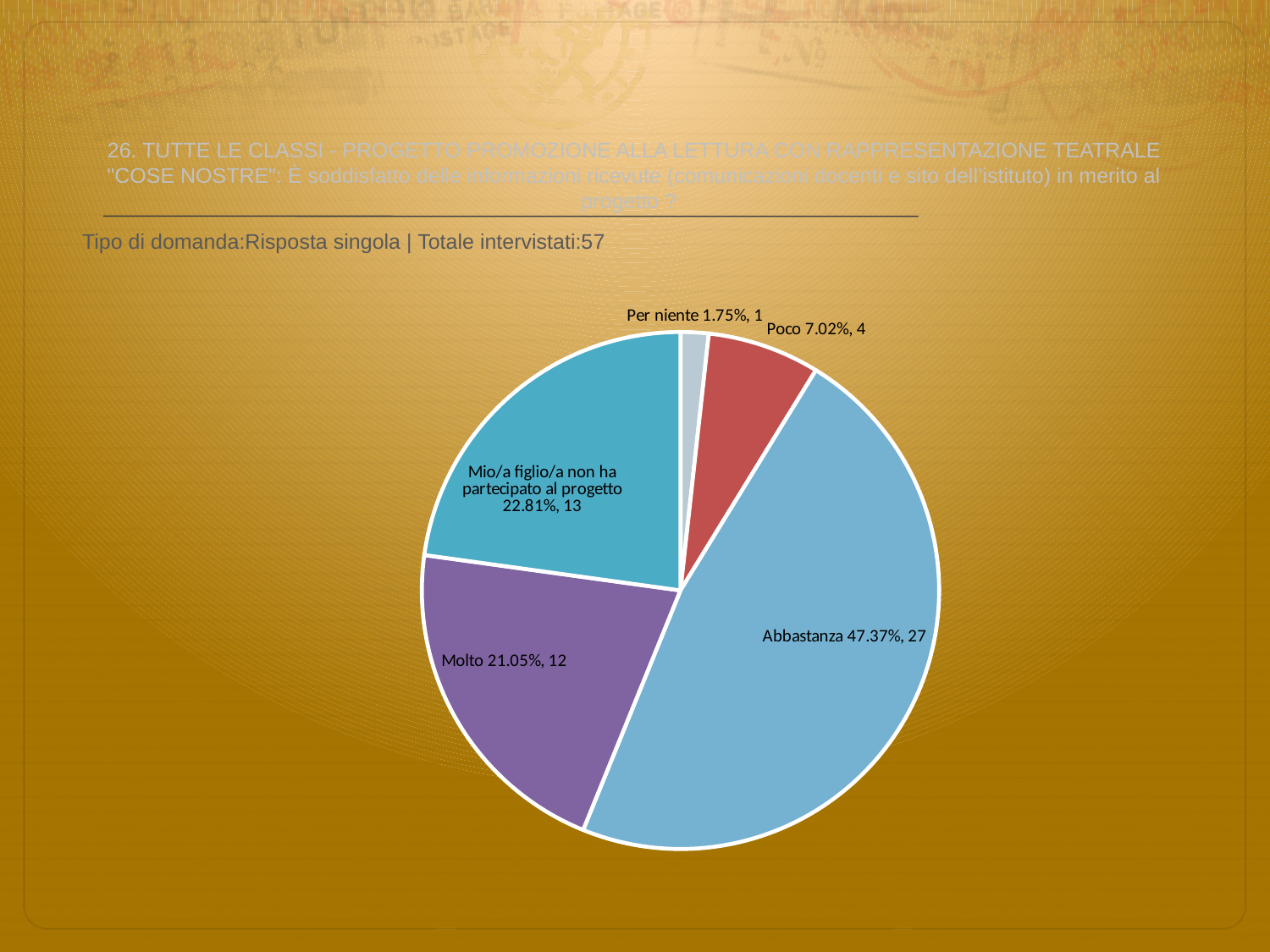
What percentage share does the 'Poco' slice have? 7.02% How many slices does the pie chart have? 5 What is the difference in respondent count between 'Abbastanza' and 'Molto'? 15 What percentage share does the 'Per niente' slice have? 1.75% Which category has the largest slice of the pie? Abbastanza Which category has the smallest slice of the pie? Per niente How many respondents answered 'Mio/a figlio/a non ha partecipato al progetto'? 13 What kind of chart is shown on the slide? pie chart How many respondents answered 'Molto'? 12 Which has more respondents, 'Poco' or 'Per niente'? Poco What is the total number of respondents stated on the slide? 57 What percentage share does the 'Abbastanza' slice have? 47.37%